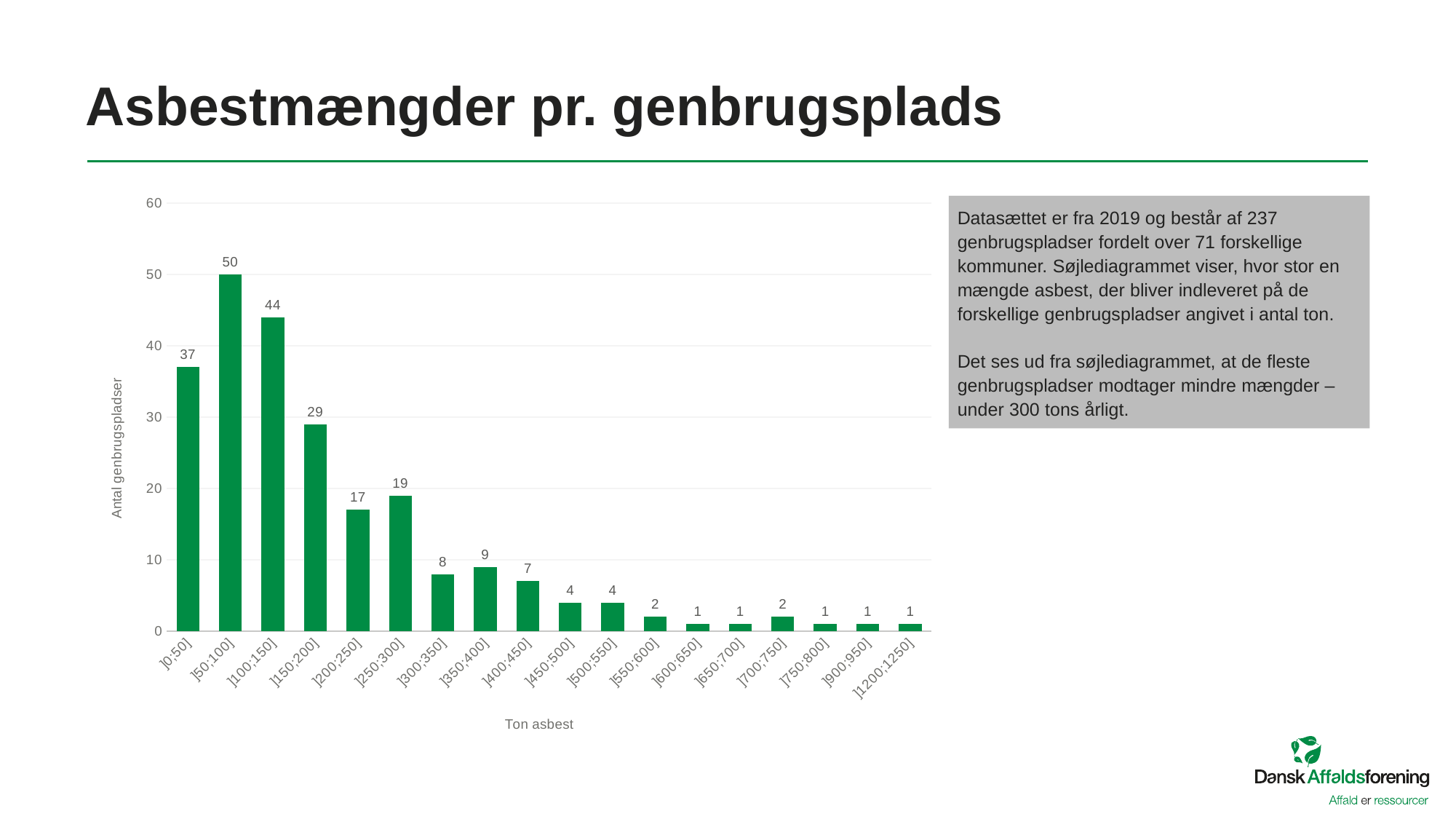
What is the value for the ]0;50] category? 37 What is the value for the ]250;300] category? 19 What is the difference between the values for ]100;150] and ]150;200]? 15 Which is larger, the value for ]200;250] or the value for ]250;300]? ]250;300] Do the values generally rise or fall from ]100;150] to ]550;600] along the x axis? fall Which category has the highest value? ]50;100] What kind of chart is shown on the slide? bar chart How many categories are shown on the x axis? 18 What is the label of the y axis? Antal genbrugspladser What is the value for the ]50;100] category? 50 Is the value for ]100;150] greater or less than 40? greater What is the label of the x axis? Ton asbest